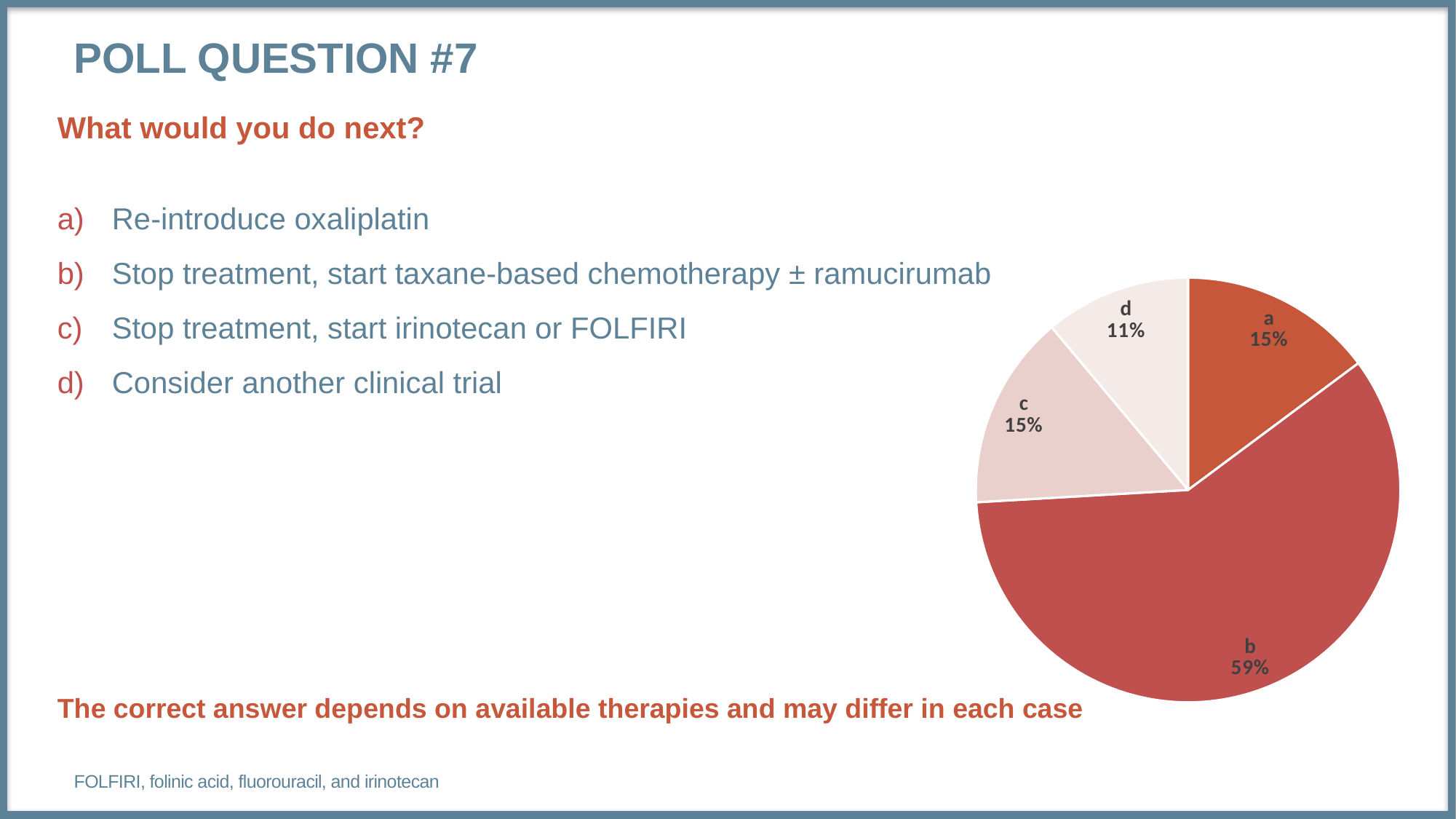
Which option received the smallest share of responses? d Which received a larger share of responses, option b or option d? b What percentage of respondents chose option c? 15% What percentage of respondents chose option d? 11% What is the combined share of options a and c? 30% How many slices does the pie chart have? 4 What is the difference in percentage points between option b and option a? 44 Which option received the largest share of responses? b What percentage of respondents chose option a? 15% What percentage of respondents chose option b? 59% What is the difference in percentage points between option c and option d? 4 What type of chart is shown on the slide? pie chart